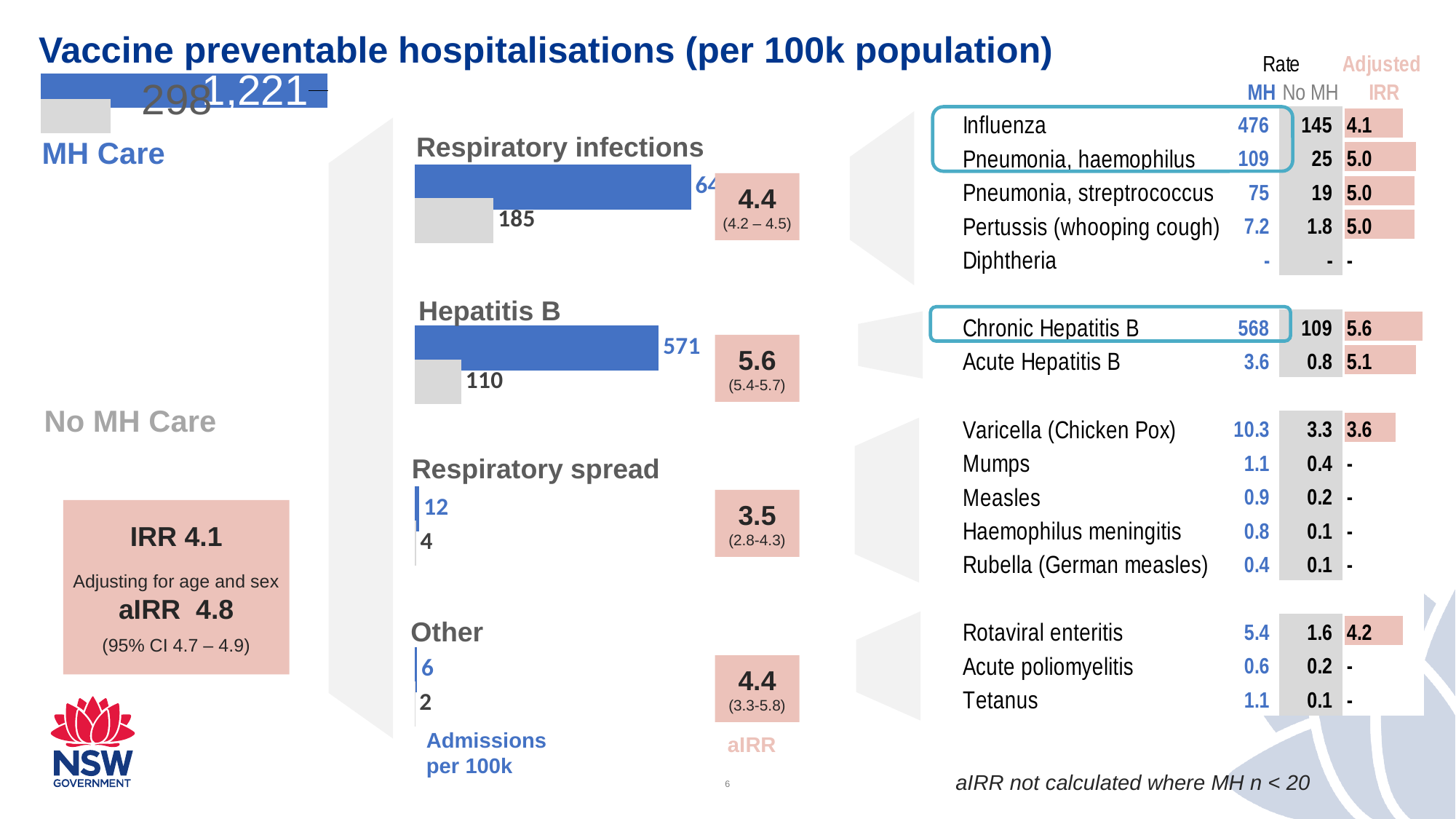
In the top-left chart, what is the value for No MH Care? 298 What is the aIRR shown next to the Respiratory spread chart? 3.5 In the Respiratory infections chart, what is the value for No MH Care? 185 In the Respiratory infections chart, which is larger, the MH Care bar or the No MH Care bar? MH Care In the Hepatitis B chart, what is the admissions per 100k value for MH Care? 571 In the Hepatitis B chart, what is the difference between the MH Care and No MH Care values? 461 In the Hepatitis B chart, what is the admissions per 100k value for No MH Care? 110 What kind of chart is used to show the Hepatitis B admissions per 100k? Bar chart In the Other chart, what is the value for No MH Care? 2 In the Respiratory spread chart, what is the value for MH Care? 12 In the top-left chart, what is the difference between the MH Care and No MH Care values? 923 In the top-left chart, what is the value for MH Care? 1,221